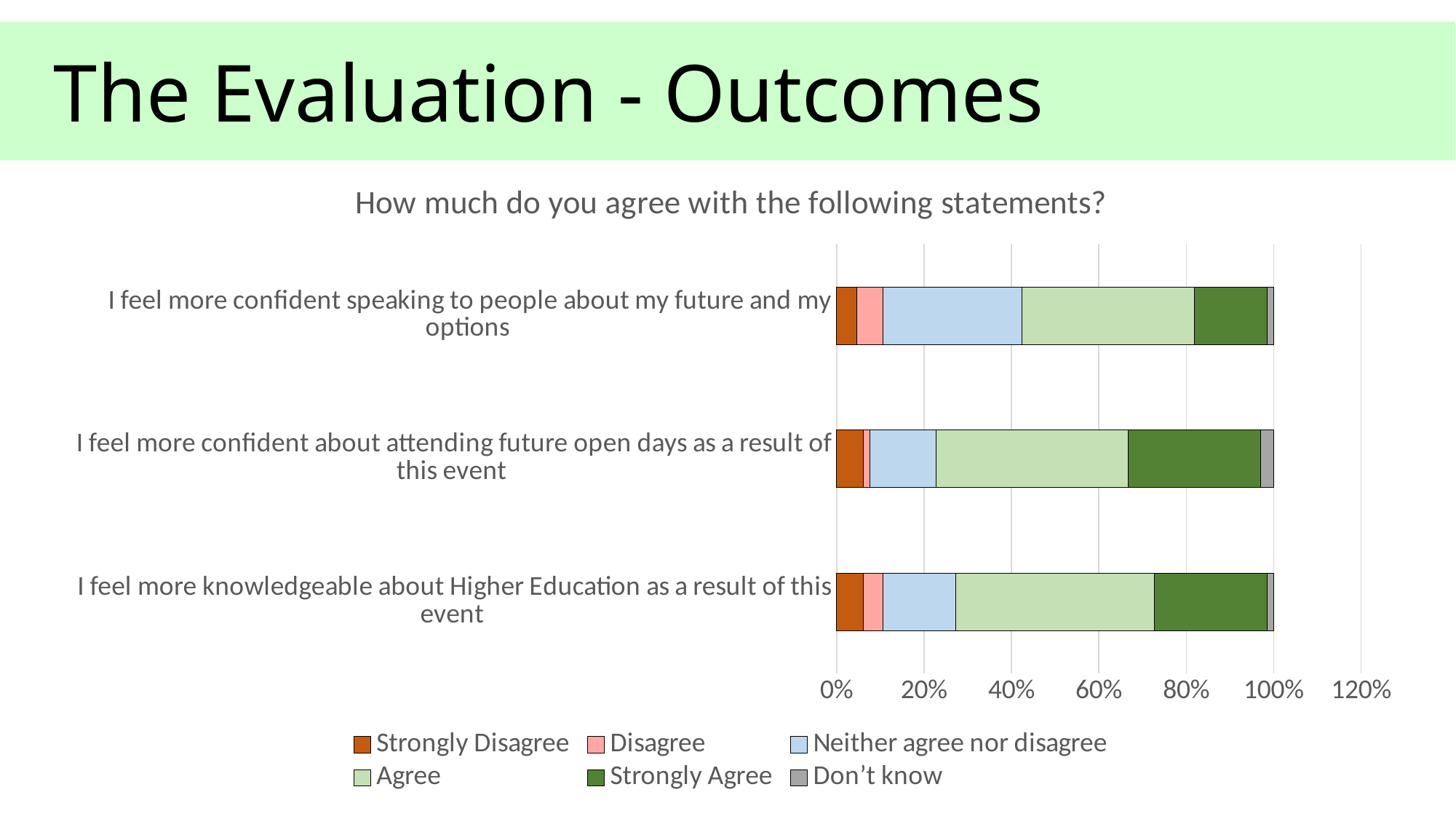
Which legend entry is shown in grey? Don't know Which statement has the largest 'Neither agree nor disagree' segment? I feel more confident speaking to people about my future and my options Is the 'Strongly Agree' share for 'I feel more confident about attending future open days as a result of this event' greater or less than 20%? greater Which statement has the smallest 'Disagree' segment? I feel more confident about attending future open days as a result of this event Is the 'Strongly Agree' segment larger for 'I feel more confident about attending future open days as a result of this event' or for 'I feel more confident speaking to people about my future and my options'? I feel more confident about attending future open days as a result of this event How many statements (categories) are plotted in the chart? 3 How many series does the legend list? 6 Is the 'Neither agree nor disagree' segment larger for 'I feel more confident speaking to people about my future and my options' or for 'I feel more confident about attending future open days as a result of this event'? I feel more confident speaking to people about my future and my options Is the 'Agree' share for 'I feel more knowledgeable about Higher Education as a result of this event' greater or less than 20%? greater Is the 'Strongly Disagree' share for 'I feel more knowledgeable about Higher Education as a result of this event' greater or less than 20%? less What is the title of the chart? How much do you agree with the following statements? What kind of chart is shown on the slide? Stacked bar chart